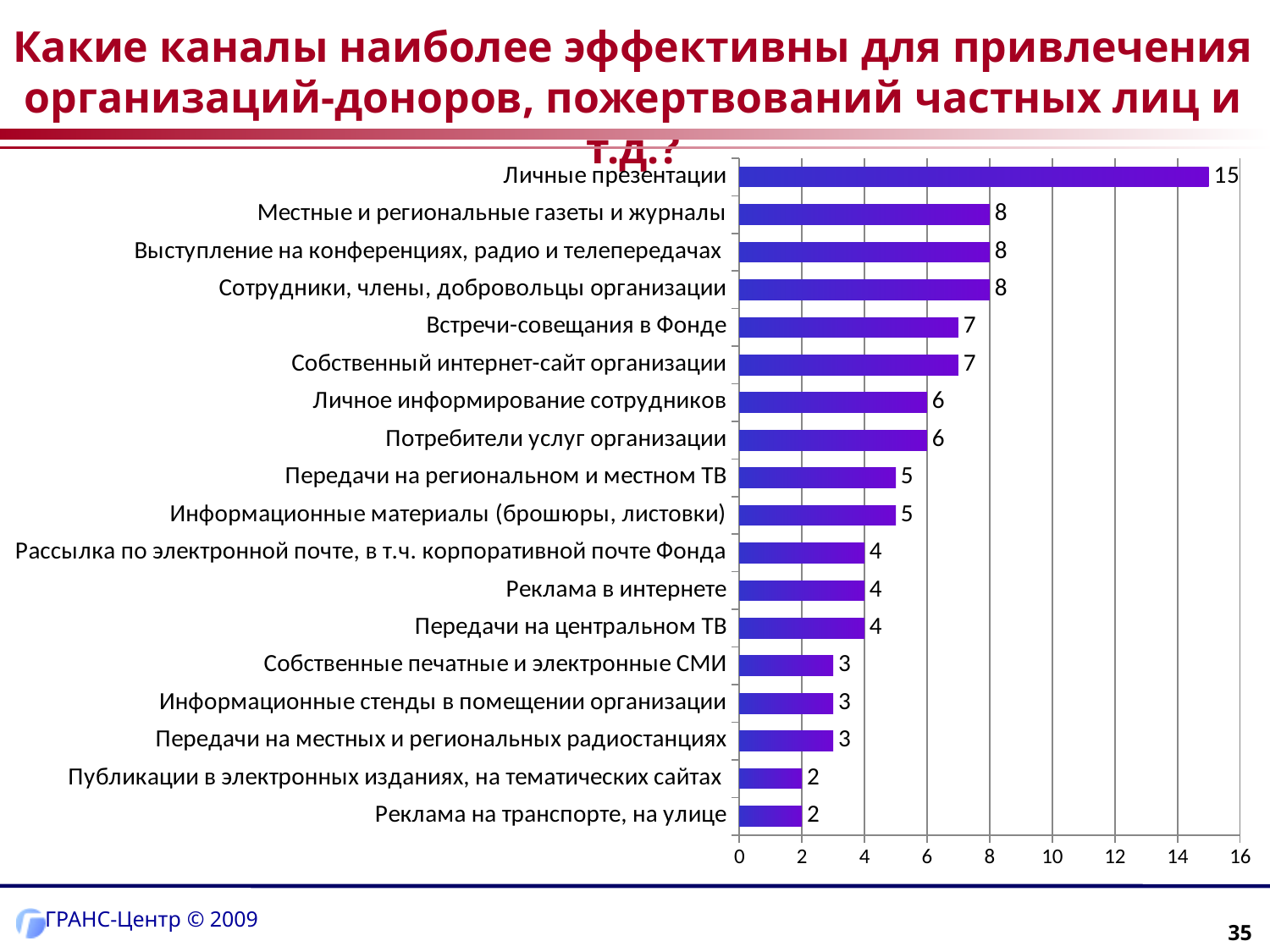
What value is shown for "Реклама в интернете"? 4 Which category has the highest value? Личные презентации What value is shown for "Реклама на транспорте, на улице"? 2 Is the value for "Личные презентации" greater or less than 10? greater What value is shown for "Личные презентации"? 15 Which is larger: the value for "Потребители услуг организации" or the value for "Передачи на центральном ТВ"? Потребители услуг организации What kind of chart is shown on the slide? bar chart What is the lowest value shown on the chart? 2 What is the maximum value shown on the horizontal axis? 16 How many categories are shown on the chart? 18 What is the difference between the values for "Личные презентации" and "Местные и региональные газеты и журналы"? 7 What value is shown for "Встречи-совещания в Фонде"? 7